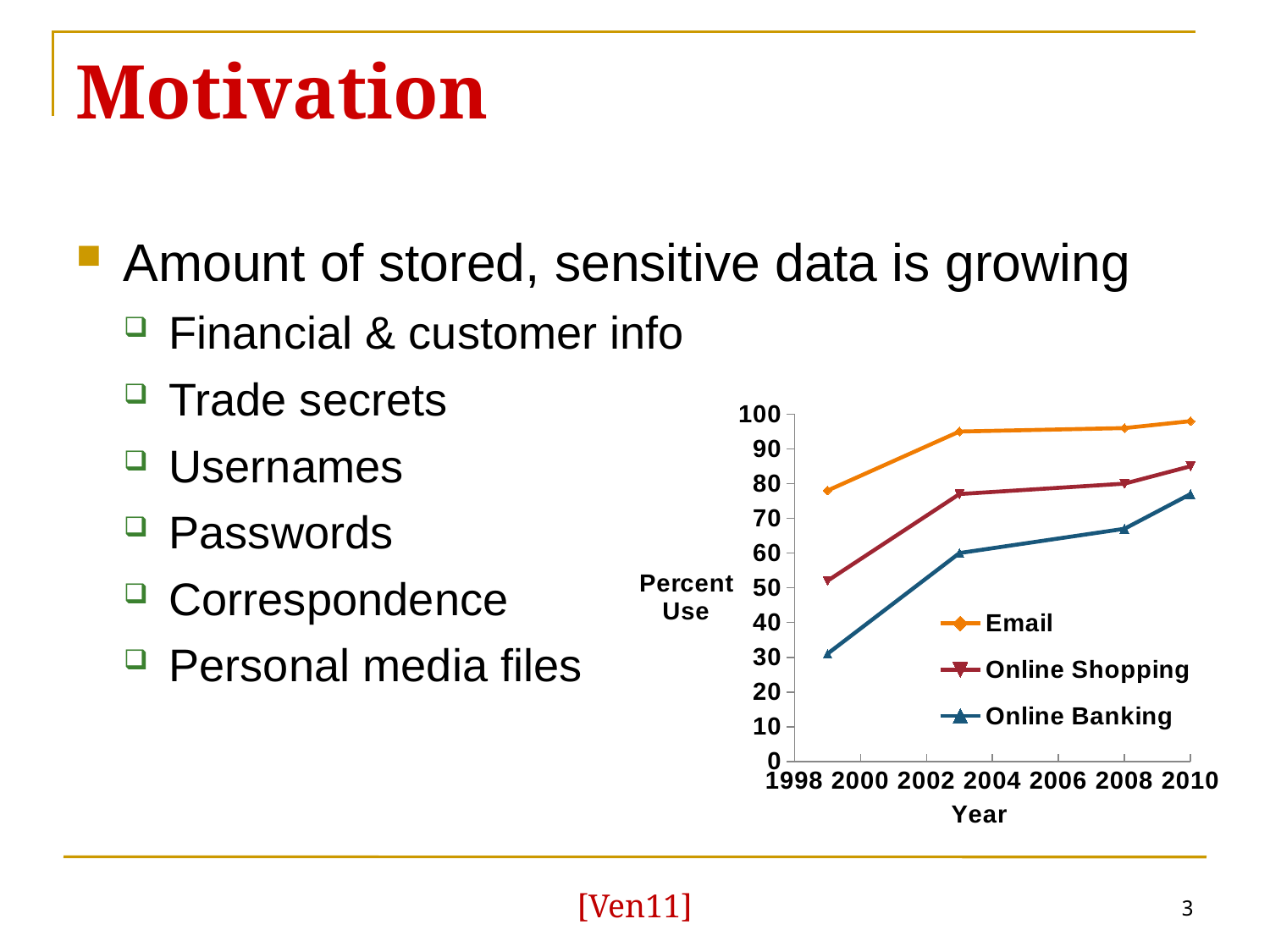
What kind of chart is shown on the slide? line chart What is the label on the chart's horizontal axis? Year Is the latest plotted value for Email greater or less than 90? greater Is the latest plotted value for Online Shopping greater or less than 80? greater How many series does the chart's legend list? 3 Is the earliest plotted value for Online Banking greater or less than 40? less Which series has the highest values across all years in the chart? Email Does the Online Banking line rise or fall from 1998 to 2010? rise What is the label on the chart's vertical axis? Percent Use Which series has the lowest values across all years in the chart? Online Banking Which is larger in 2008, the value for Online Shopping or the value for Online Banking? Online Shopping Which is larger in 2010, the value for Email or the value for Online Banking? Email